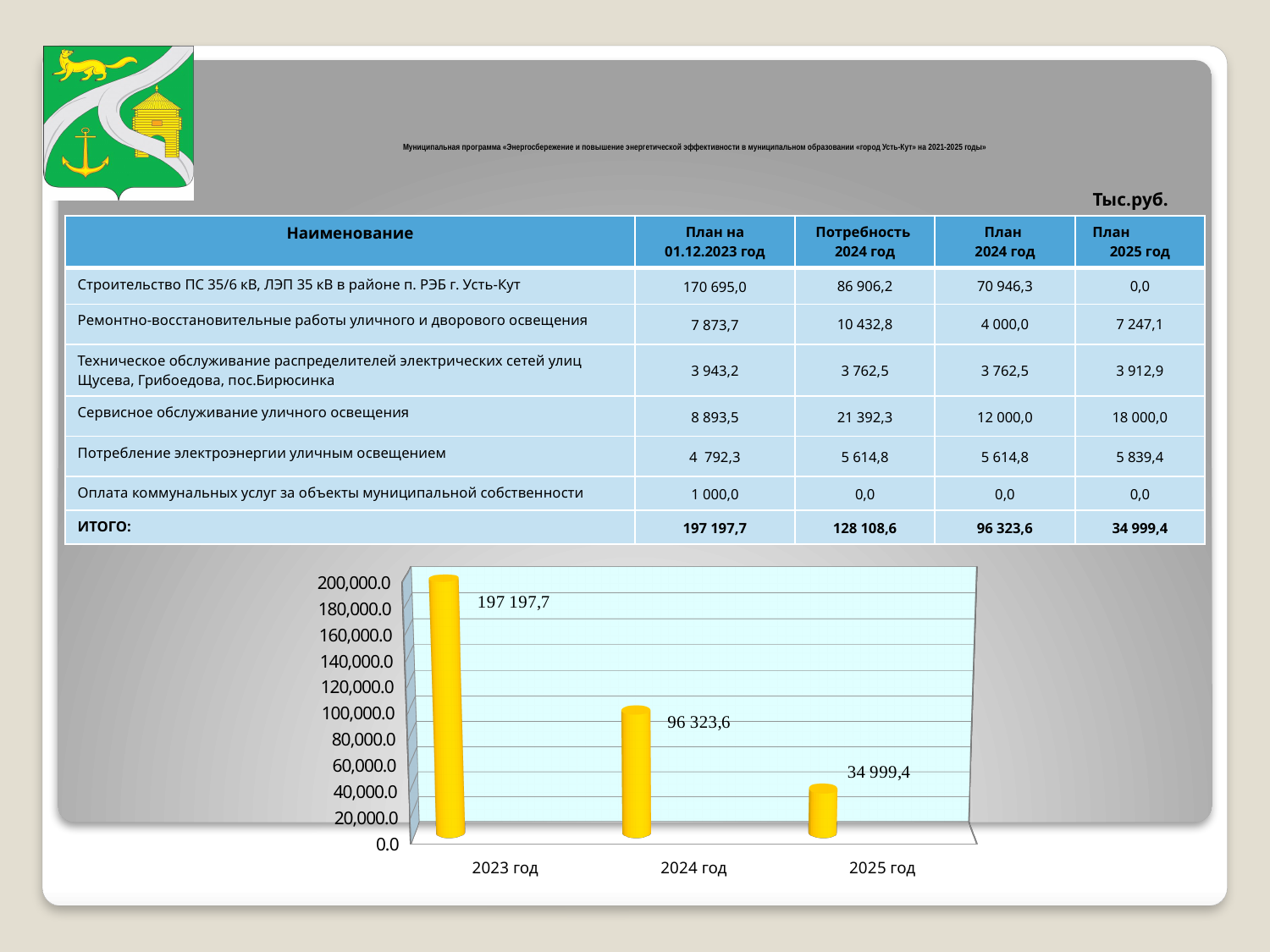
What is the difference between the values for 2023 год and 2024 год in the chart? 100 874,1 Is the value for 2024 год in the chart greater or less than 80,000.0? greater How many bars are plotted in the chart? 3 What is the value shown for 2023 год in the chart? 197 197,7 What kind of chart is shown on the slide? bar chart What is the value shown for 2025 год in the chart? 34 999,4 Which is larger in the chart, the value for 2024 год or the value for 2025 год? 2024 год What is the difference between the values for 2024 год and 2025 год in the chart? 61 324,2 What is the value shown for 2024 год in the chart? 96 323,6 Which year has the lowest value in the chart? 2025 год Which year has the highest value in the chart? 2023 год Do the values in the chart rise or fall from 2023 год to 2025 год? fall